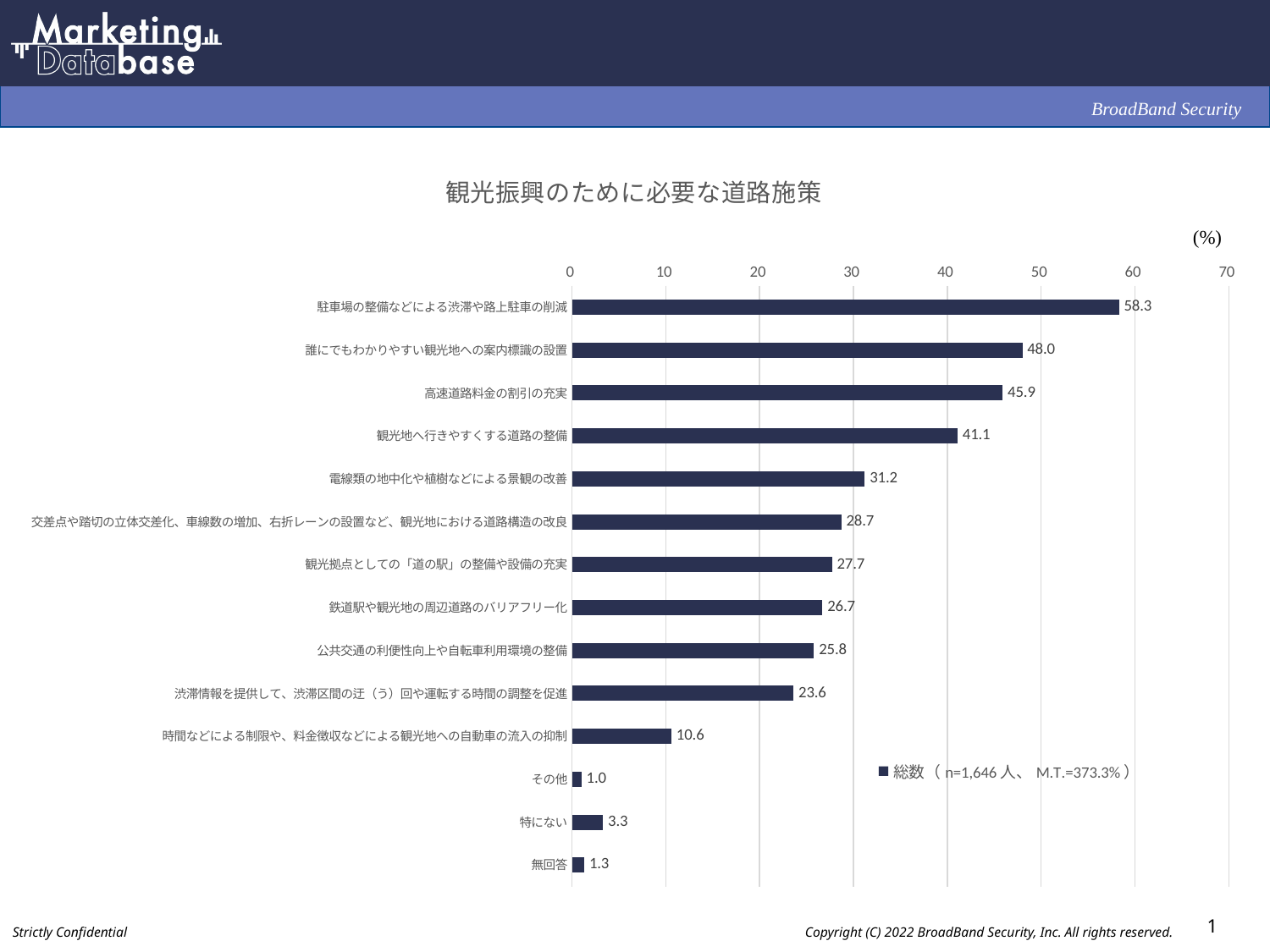
How many series does the legend list? 1 Which category has the highest value? 駐車場の整備などによる渋滞や路上駐車の削減 What is the difference between the values for 誰にでもわかりやすい観光地への案内標識の設置 and 観光地へ行きやすくする道路の整備? 6.9 How many categories are plotted in the chart? 14 What is the value for 特にない? 3.3 What is the value for 駐車場の整備などによる渋滞や路上駐車の削減? 58.3 What is the value for 高速道路料金の割引の充実? 45.9 What is the title of the chart? 観光振興のために必要な道路施策 What type of chart is shown on the slide? Bar chart What is the value for 鉄道駅や観光地の周辺道路のバリアフリー化? 26.7 Which category has the lowest value? その他 Which is larger: the value for 電線類の地中化や植樹などによる景観の改善 or the value for 公共交通の利便性向上や自転車利用環境の整備? 電線類の地中化や植樹などによる景観の改善